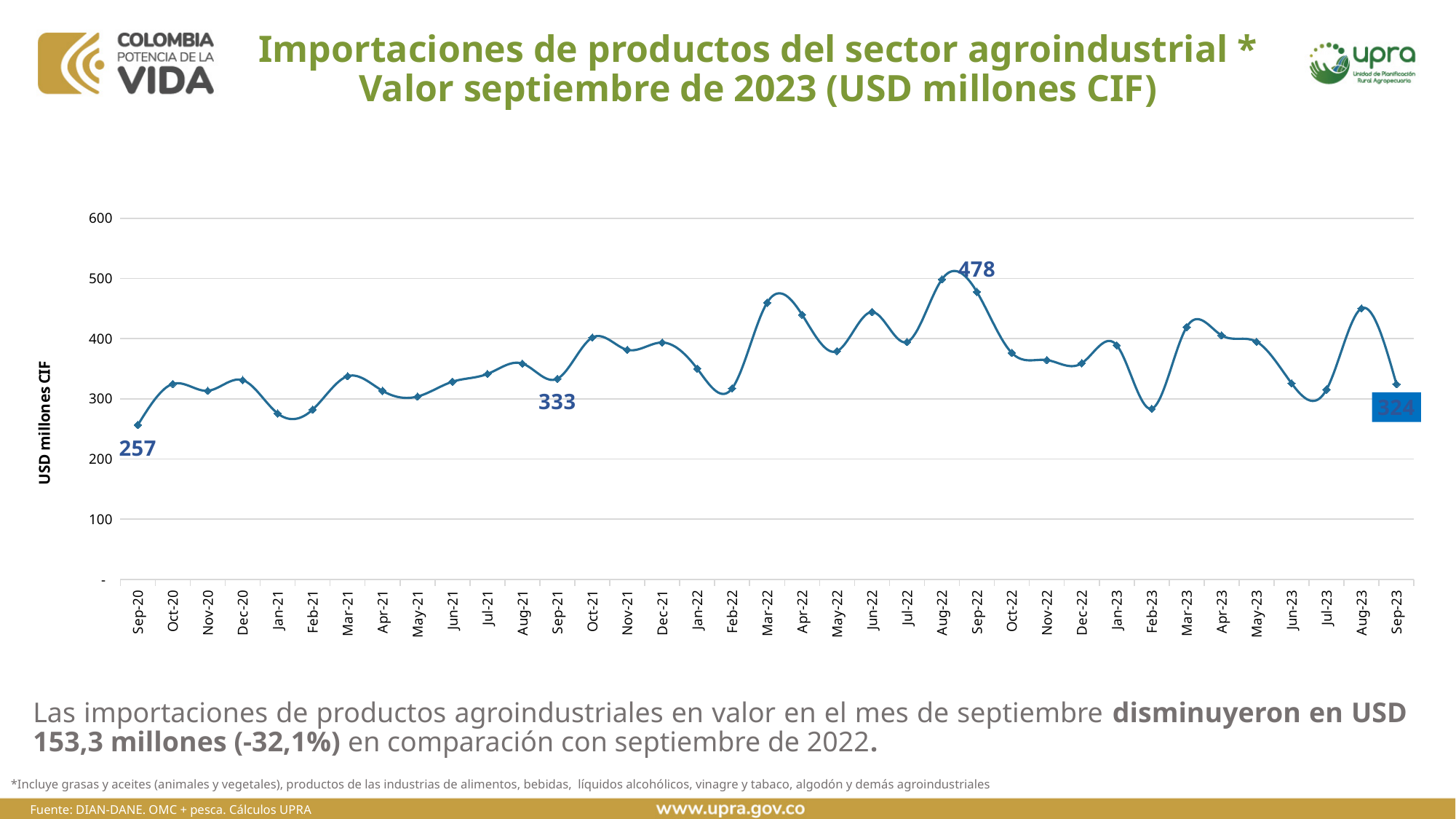
Which month has the lowest value on the chart? Sep-20 What kind of chart is shown on the slide? line chart How many monthly data points are plotted on the chart? 37 What is the value for Sep-20? 257 Is the value for Mar-22 greater or less than 400? greater Which is larger, the value for Sep-22 or the value for Sep-23? Sep-22 What is the value for Sep-22? 478 What is the difference between the values for Sep-21 and Sep-20? 76 What is the value for Sep-21? 333 Is the value for Feb-23 greater or less than 300? less What is the label of the vertical axis? USD millones CIF What is the value for Sep-23? 324